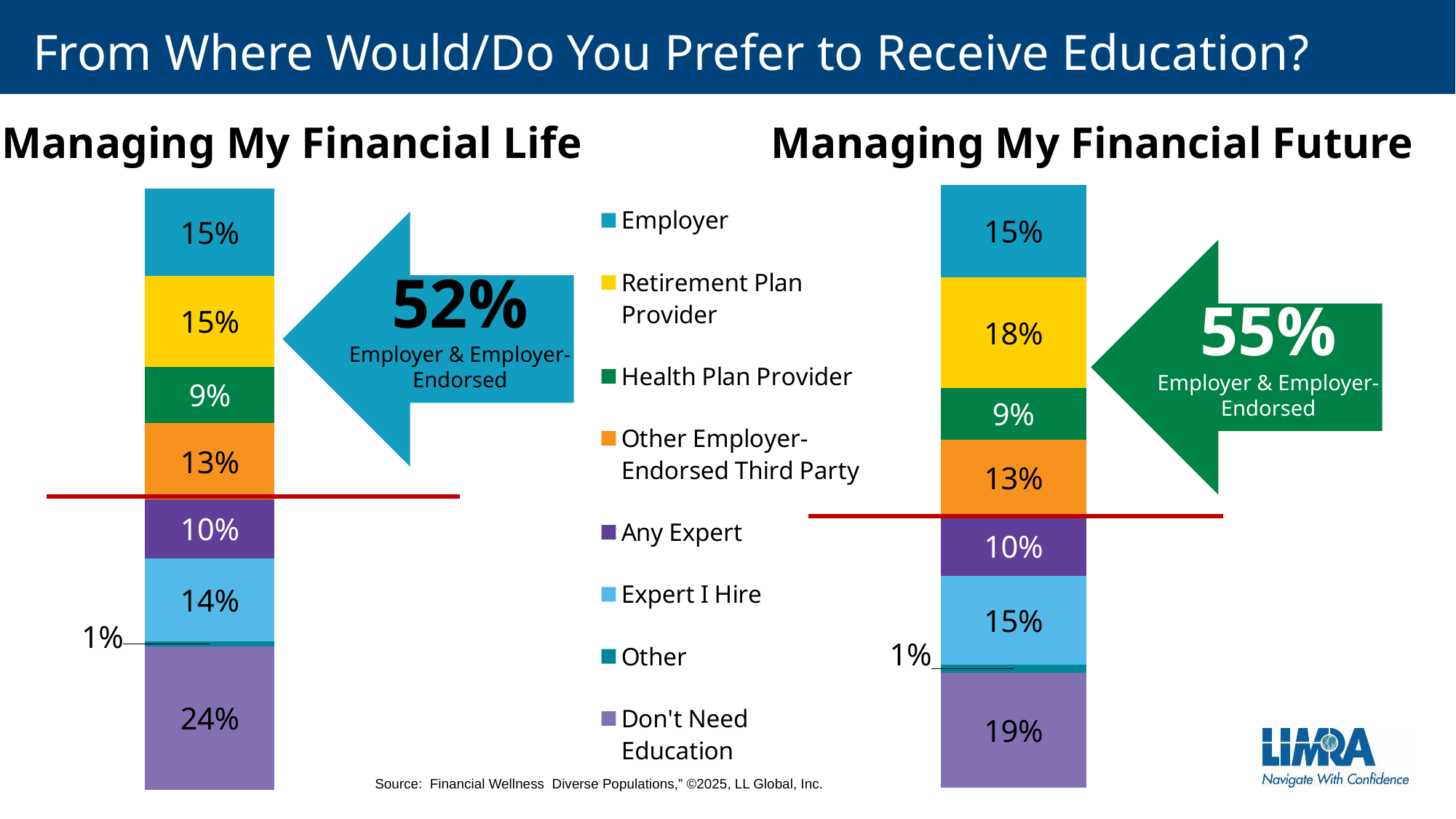
In the Managing My Financial Future chart, which is larger: Retirement Plan Provider or Employer? Retirement Plan Provider In the Managing My Financial Future chart, what percentage is shown for Expert I Hire? 15% In the Managing My Financial Future chart, what percentage is shown for Retirement Plan Provider? 18% How many series does the legend list? 8 What kind of chart is used on this slide? Stacked bar chart In the Managing My Financial Life chart, what percentage is shown for Other Employer-Endorsed Third Party? 13% In the Managing My Financial Life chart, which segment has the largest value? Don't Need Education What is the difference between the Don't Need Education values in the Managing My Financial Life chart and the Managing My Financial Future chart? 5% In the Managing My Financial Life chart, what percentage is shown for Don't Need Education? 24% In the Managing My Financial Life chart, what is the combined value of Employer, Retirement Plan Provider, Health Plan Provider and Other Employer-Endorsed Third Party? 52% In the Managing My Financial Future chart, which segment has the smallest value? Other What colour represents Health Plan Provider in the legend? Green